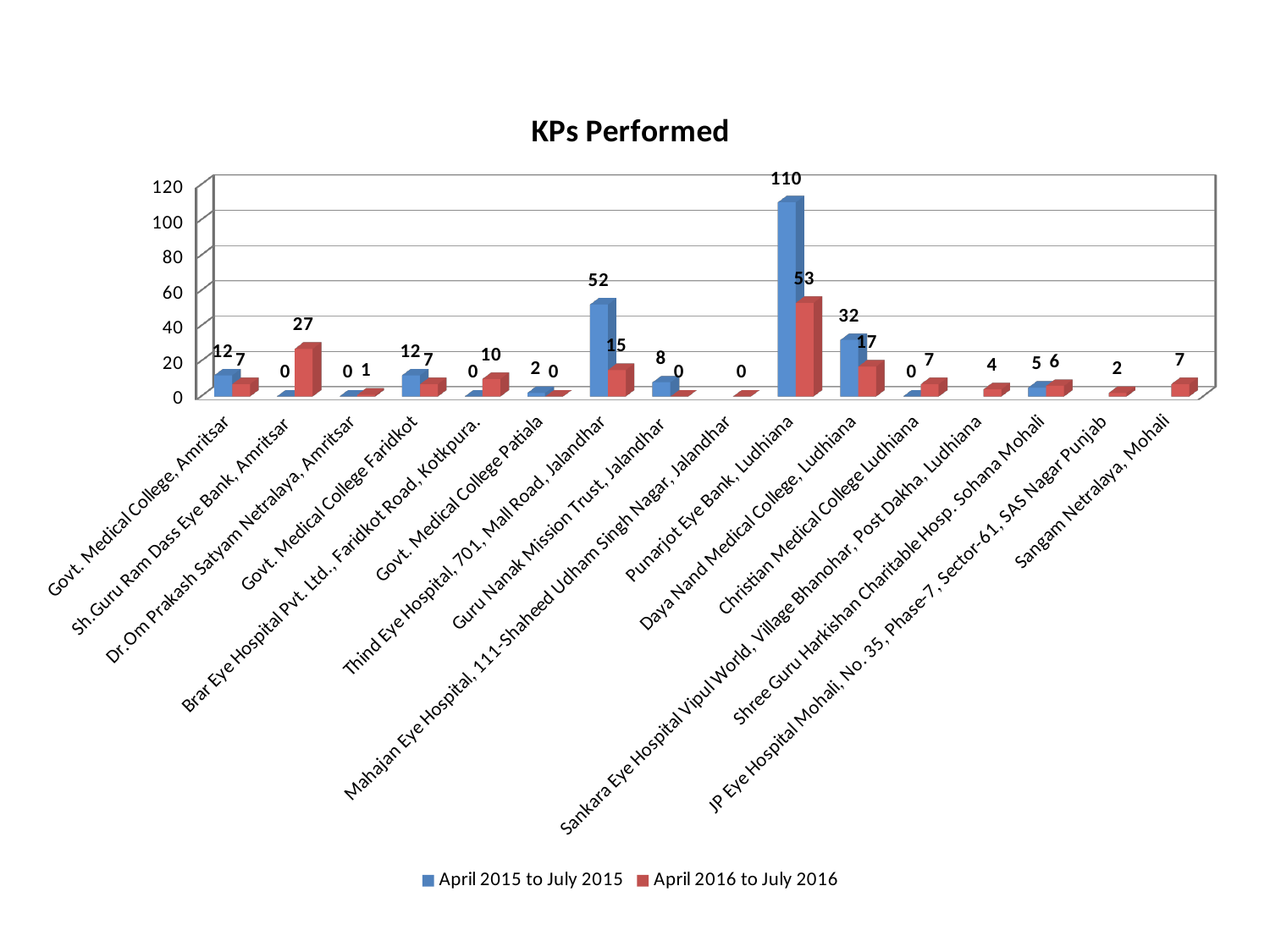
What is the difference between the April 2015 to July 2015 and April 2016 to July 2016 values for Daya Nand Medical College, Ludhiana? 15 For Shree Guru Harkishan Charitable Hosp. Sohana Mohali, which series has the larger value? April 2016 to July 2016 What is the value for Sh.Guru Ram Dass Eye Bank, Amritsar in the April 2016 to July 2016 series? 27 How many categories are shown on the x axis? 16 Which category has the highest value in the April 2016 to July 2016 series? Punarjot Eye Bank, Ludhiana What is the difference between the April 2015 to July 2015 and April 2016 to July 2016 values for Punarjot Eye Bank, Ludhiana? 57 What is the value for Punarjot Eye Bank, Ludhiana in the April 2015 to July 2015 series? 110 What type of chart is shown on the slide? Bar chart Which category has the highest value in the April 2015 to July 2015 series? Punarjot Eye Bank, Ludhiana How many series does the legend list? 2